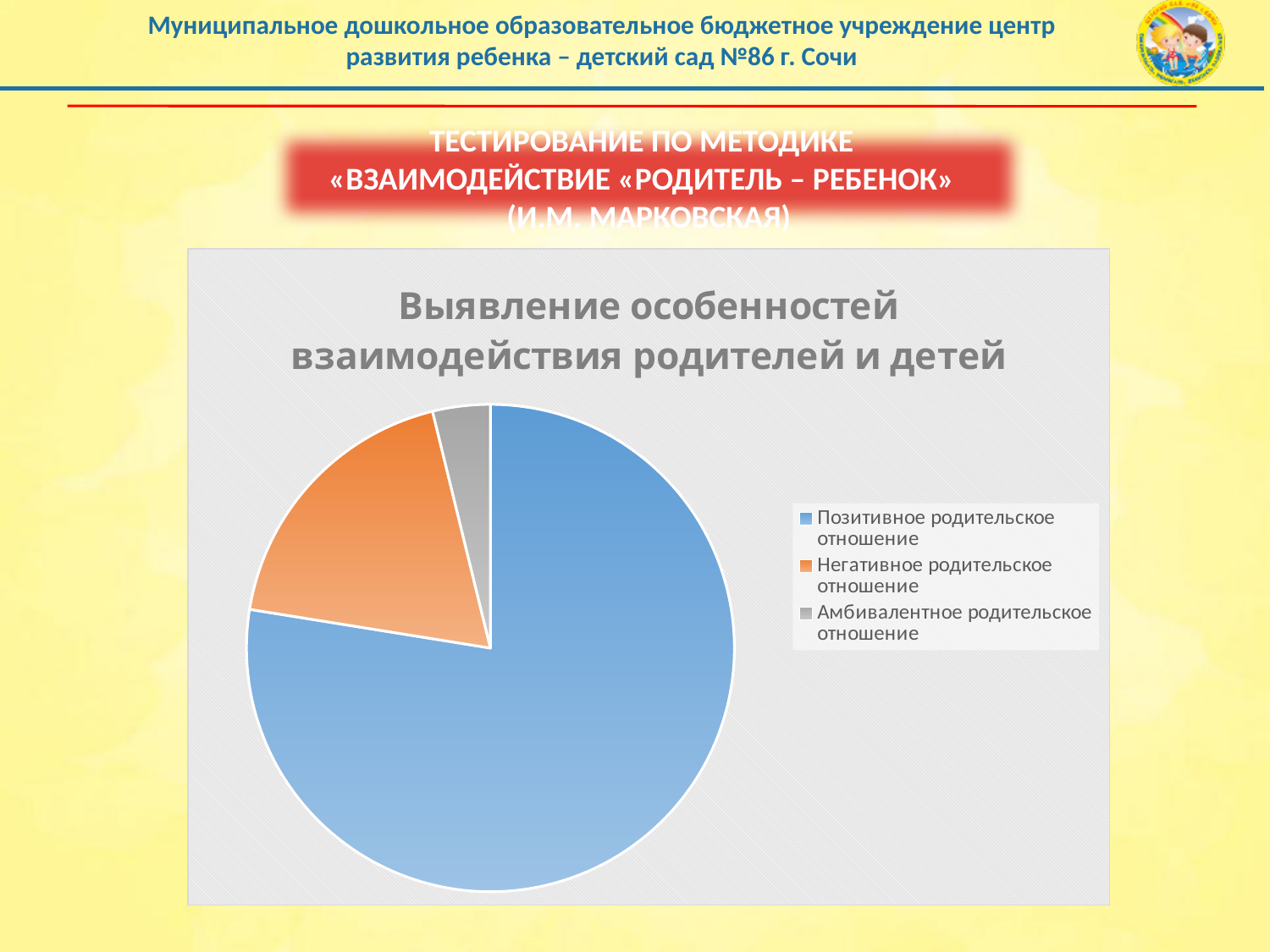
Which slice is larger: Негативное родительское отношение or Амбивалентное родительское отношение? Негативное родительское отношение Does the slice for Позитивное родительское отношение take up more or less than half of the pie? more Which category has the largest slice of the pie? Позитивное родительское отношение Which slice is larger: Позитивное родительское отношение or Негативное родительское отношение? Позитивное родительское отношение Which category has the smallest slice of the pie? Амбивалентное родительское отношение Which colour represents Негативное родительское отношение in the pie chart? orange What is the title of the chart? Выявление особенностей взаимодействия родителей и детей What kind of chart is shown on the slide? pie chart How many entries does the legend list? 3 How many slices does the pie chart have? 3